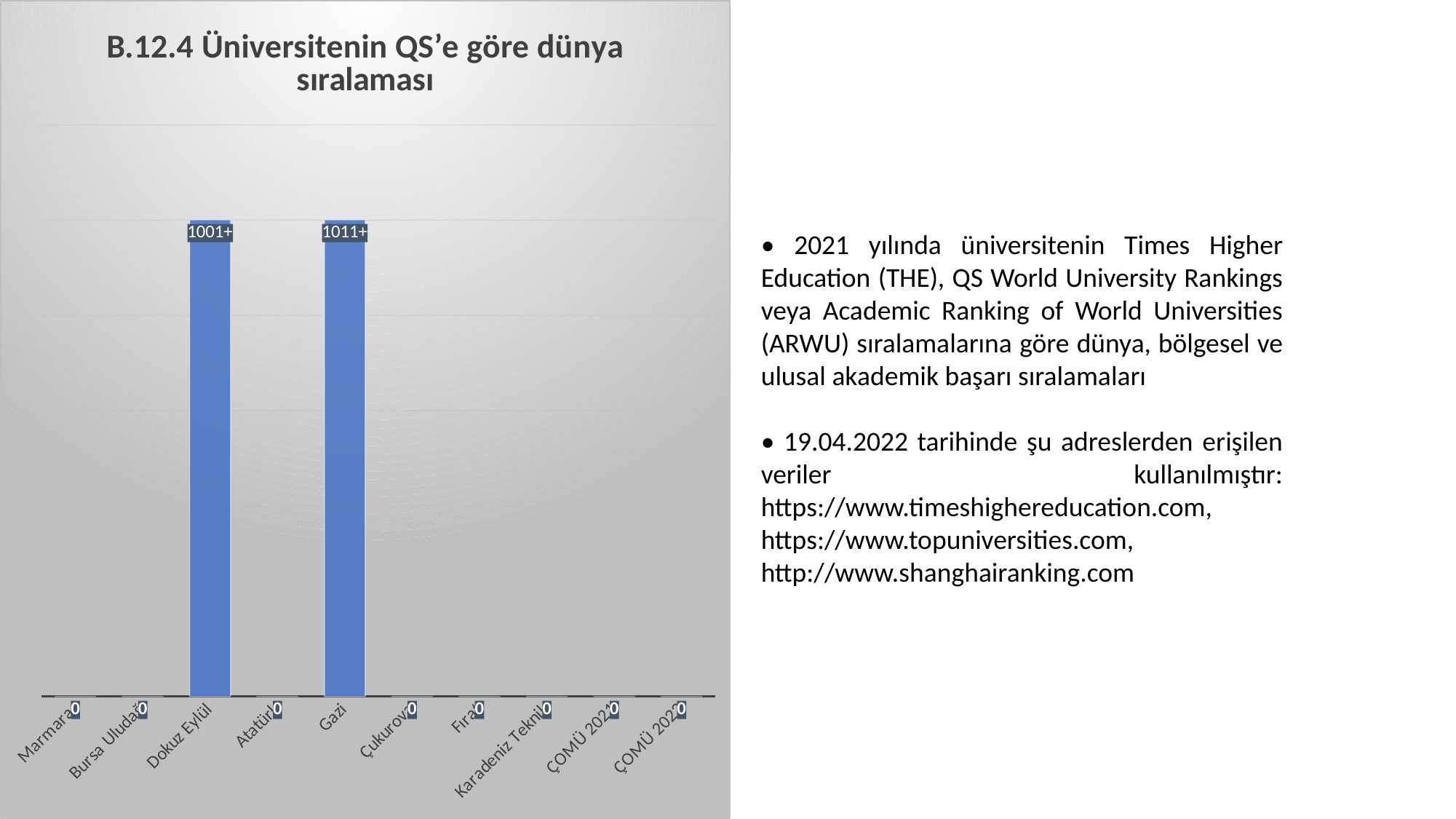
What value is shown for ÇOMÜ 2021? 0 What type of chart is shown on the slide? bar chart What value is shown for Karadeniz Teknik? 0 What is the title of the chart? B.12.4 Üniversitenin QS'e göre dünya sıralaması How many categories have a value of 0? 8 Which two universities have non-zero bars in the chart? Dokuz Eylül and Gazi What value is shown for Atatürk? 0 How many categories are shown on the x axis? 10 What value is shown for Marmara? 0 What value is shown for Gazi? 1011+ What value is shown for Dokuz Eylül? 1001+ How many categories have a non-zero bar? 2